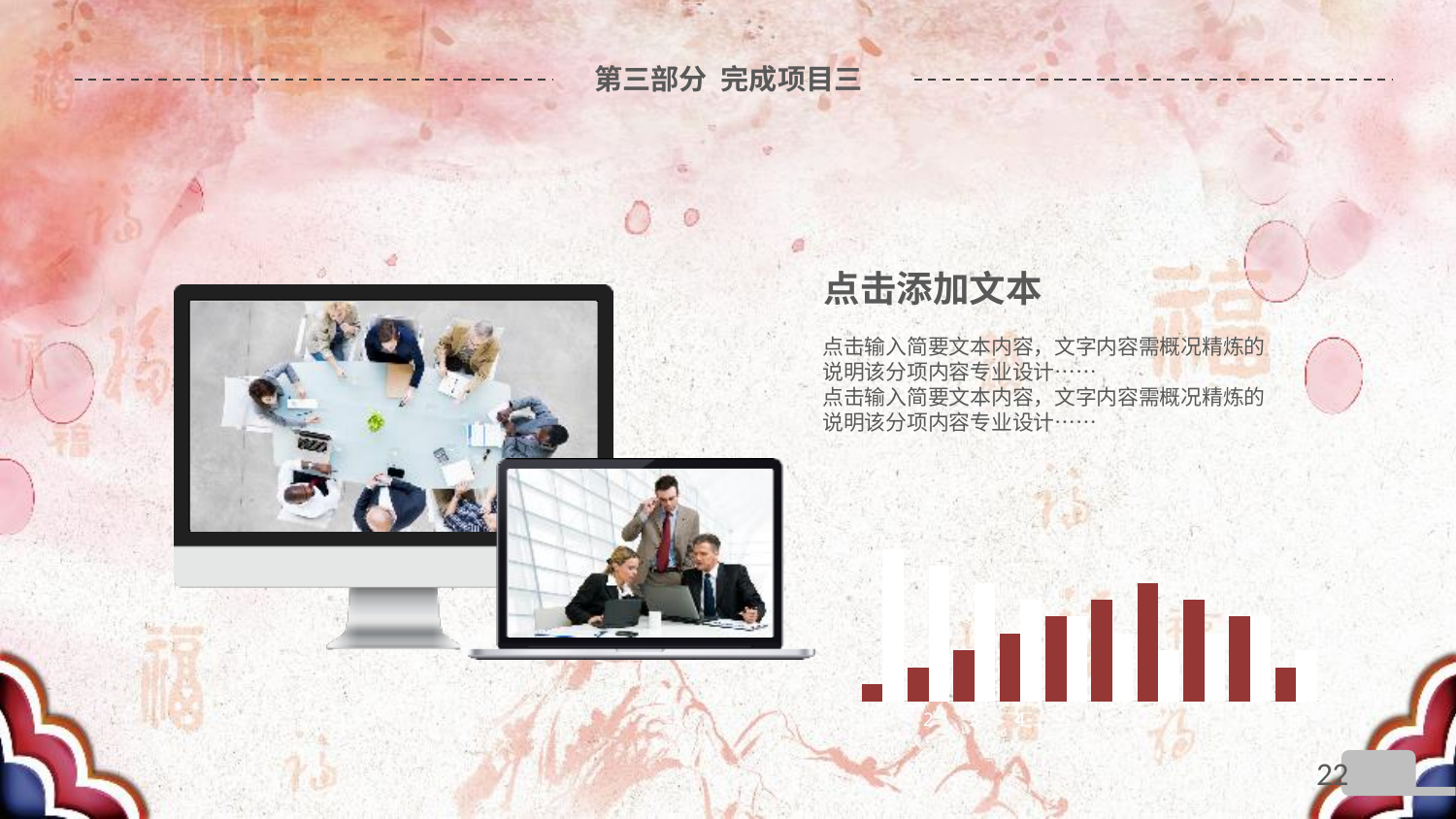
What kind of chart is shown at the bottom right of the slide? bar chart In the bar chart at the bottom right, which is taller: the first bar from the left or the seventh bar from the left? the seventh bar How many bars does the bar chart at the bottom right of the slide contain? 20 Does the bar chart at the bottom right of the slide show a legend? No What colour are the bars in the bar chart at the bottom right of the slide? dark red and white